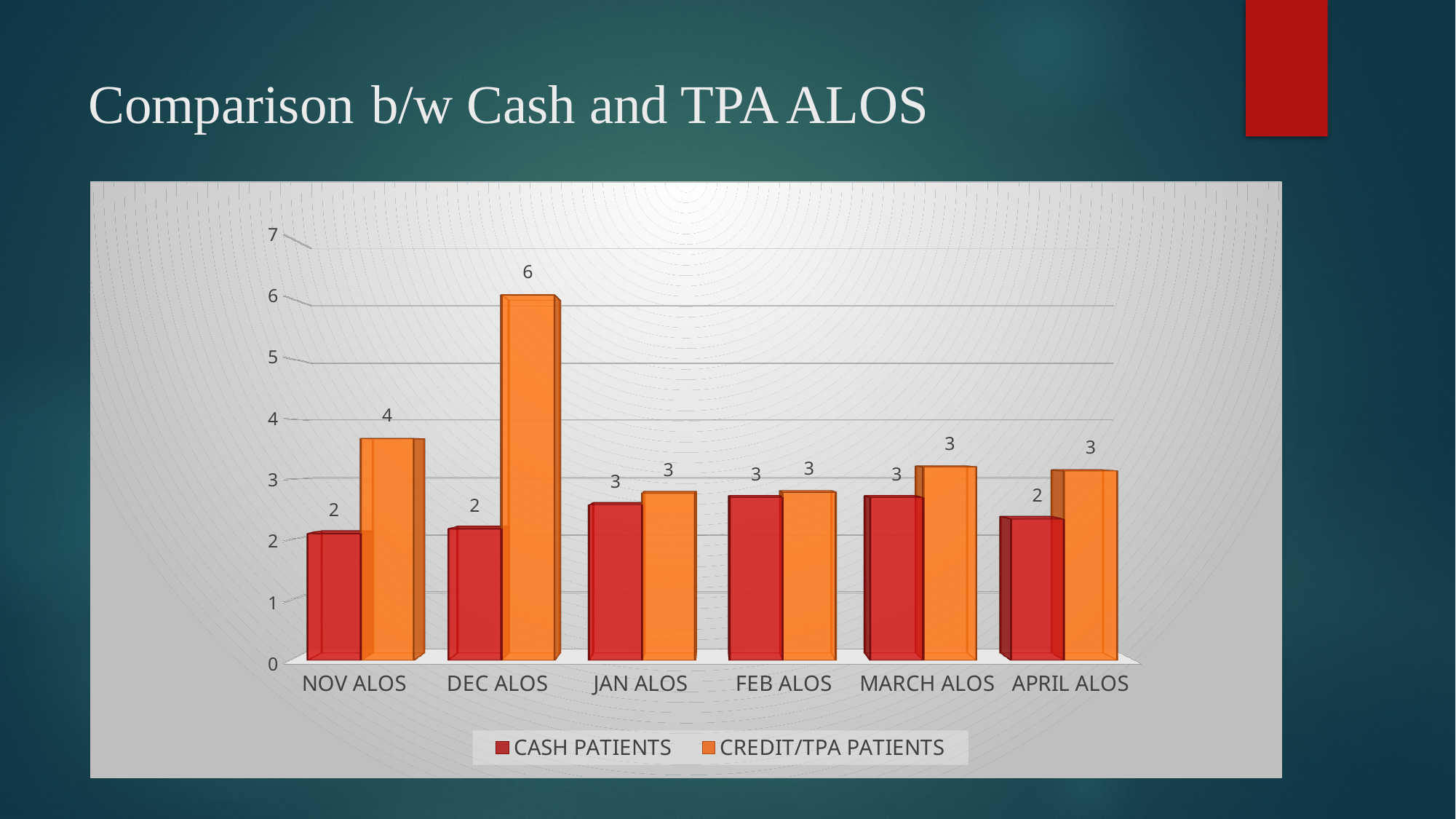
What is the value for CASH PATIENTS at NOV ALOS? 2 How many series does the legend list? 2 Is the value for CREDIT/TPA PATIENTS at DEC ALOS greater or less than 5? greater What is the difference between the CREDIT/TPA PATIENTS and CASH PATIENTS values at DEC ALOS? 4 At NOV ALOS, which is larger: the CASH PATIENTS value or the CREDIT/TPA PATIENTS value? CREDIT/TPA PATIENTS What is the title of the slide? Comparison b/w Cash and TPA ALOS What kind of chart is shown on the slide? bar chart What is the value for CREDIT/TPA PATIENTS at NOV ALOS? 4 What is the value for CREDIT/TPA PATIENTS at DEC ALOS? 6 Which category has the highest value for CREDIT/TPA PATIENTS? DEC ALOS What is the value for CASH PATIENTS at APRIL ALOS? 2 How many categories are shown on the x axis? 6